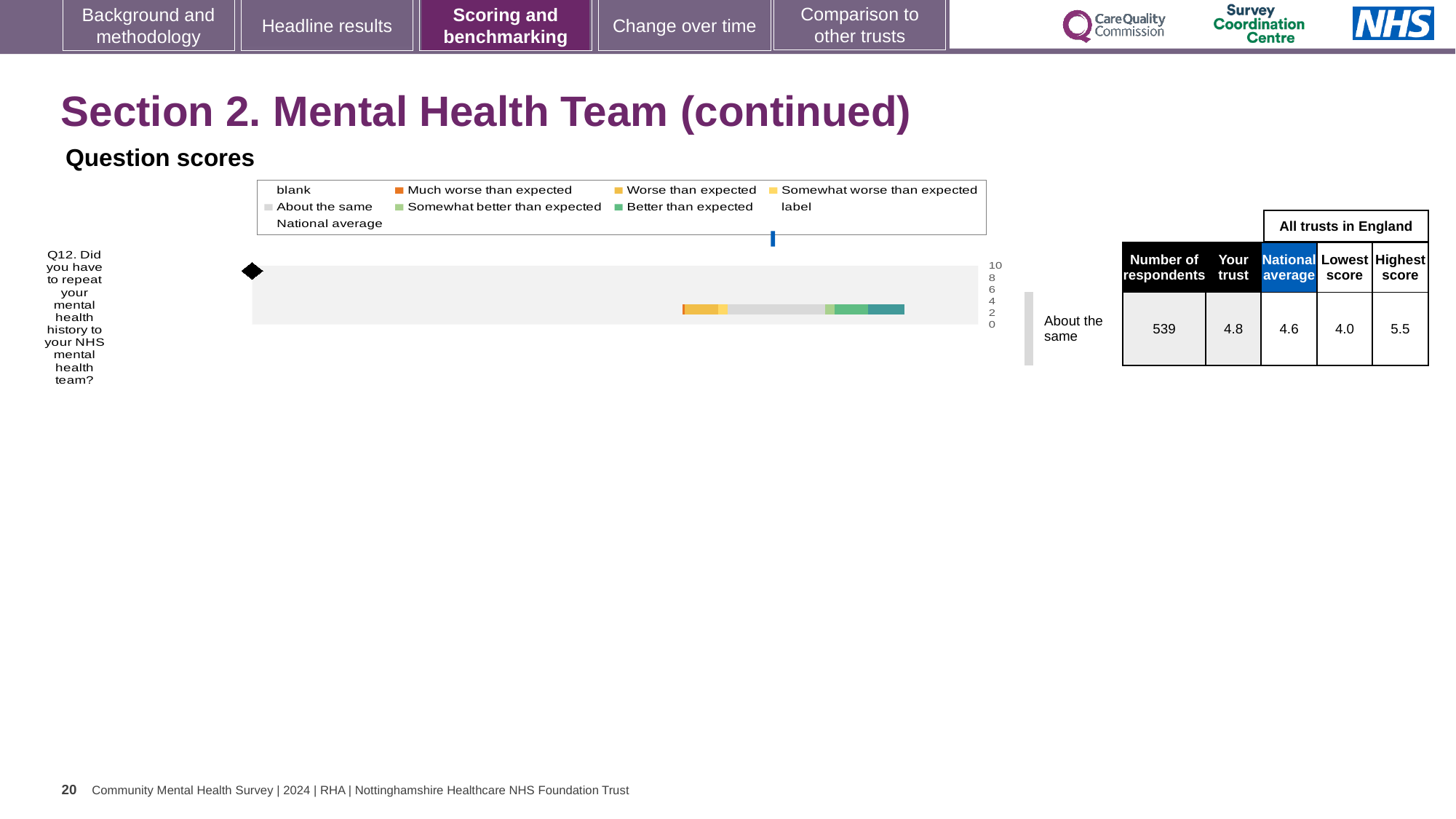
What is the difference between the highest and lowest scores for Q12? 1.5 Which question number does the chart show? Q12 Is the 'Your trust' score for Q12 higher or lower than the national average? higher What is the difference between the 'Your trust' score and the national average for Q12? 0.2 How many respondents answered Q12? 539 What is the 'Your trust' score for Q12? 4.8 What is the highest score among all trusts in England for Q12? 5.5 What is the national average score for Q12? 4.6 What is the lowest score among all trusts in England for Q12? 4.0 What benchmark category is the trust's Q12 score placed in? About the same What kind of chart is used to show the Q12 question score? bar chart How many questions are plotted on the chart? 1